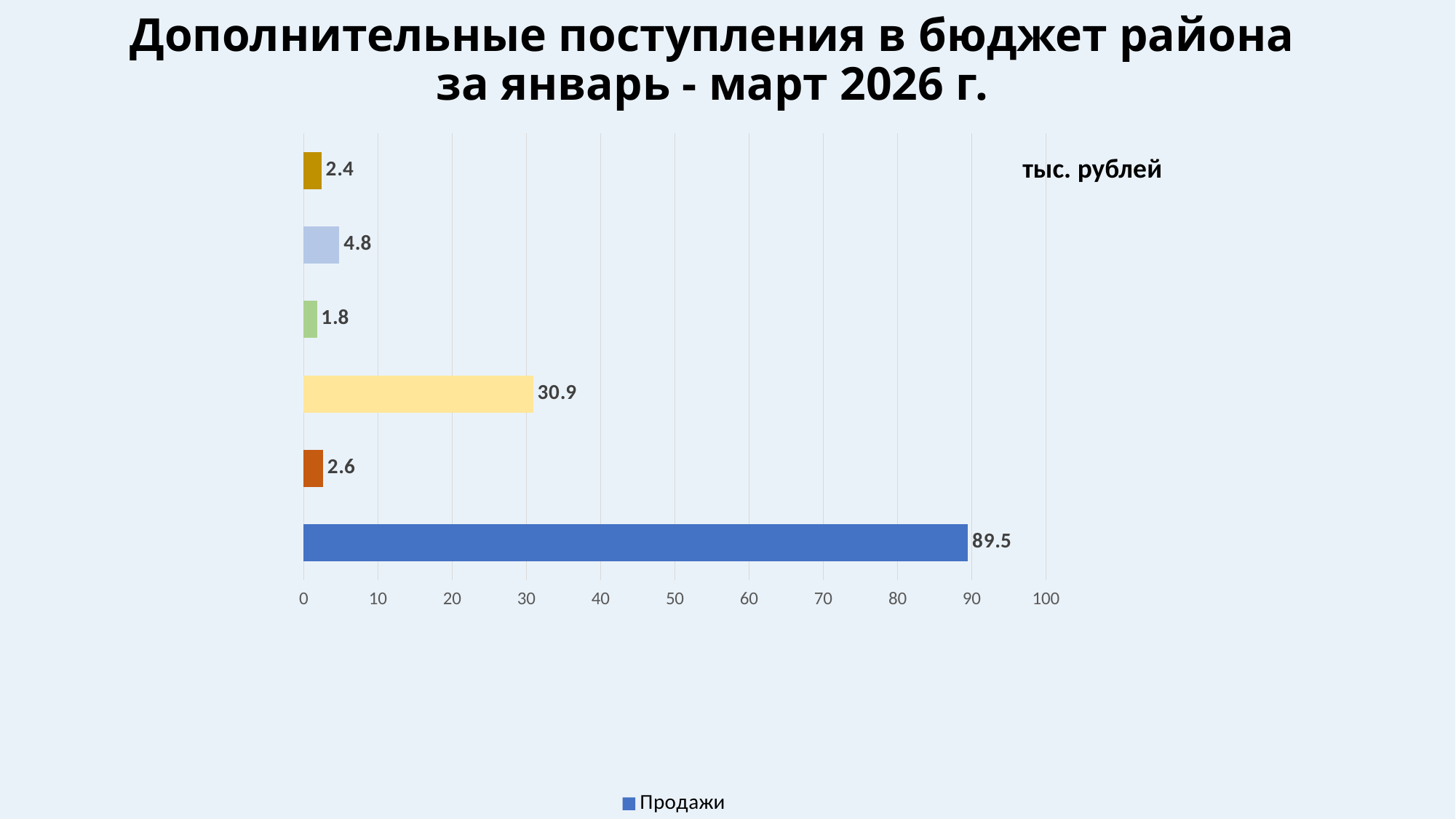
What is the value of the topmost bar? 2.4 How many bars are plotted in the chart? 6 What unit is indicated on the chart? тыс. рублей What is the value of the light yellow bar (fourth from the top)? 30.9 Which is larger: the light blue bar or the orange bar? the light blue bar (4.8) What is the value of the green bar? 1.8 What is the smallest value shown in the chart? 1.8 What type of chart is shown on the slide? bar chart How many series does the legend list? 1 What is the largest value shown in the chart? 89.5 What is the value of the bottom (dark blue) bar? 89.5 What is the difference between the bottom bar (89.5) and the light yellow bar (30.9)? 58.6